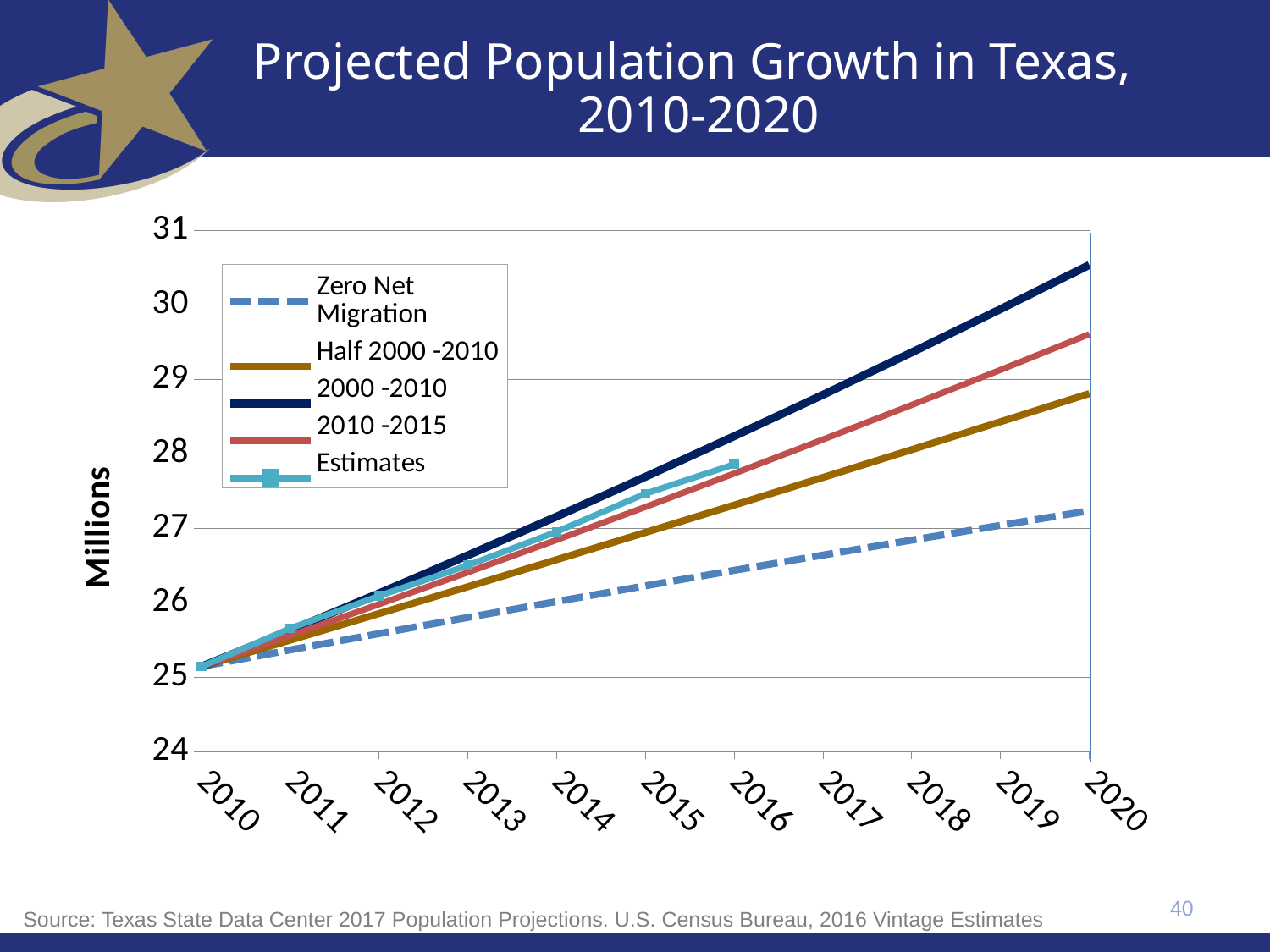
What is the label on the y axis? Millions Is the value of the 2000 -2010 series in 2020 greater or less than 30? greater Which series has the lowest value in 2020? Zero Net Migration Is the value of the Estimates series in 2016 greater or less than 28? less What kind of chart is shown on the slide? Line chart Do the values of the 2010 -2015 series rise or fall from 2010 to 2020? Rise How many series does the legend list? 5 Is the value of the Zero Net Migration series in 2020 greater or less than 28? less Which series has the highest value in 2020? 2000 -2010 How many years are labelled along the x axis? 11 In 2016, which is higher: the Estimates series or the Half 2000 -2010 series? Estimates